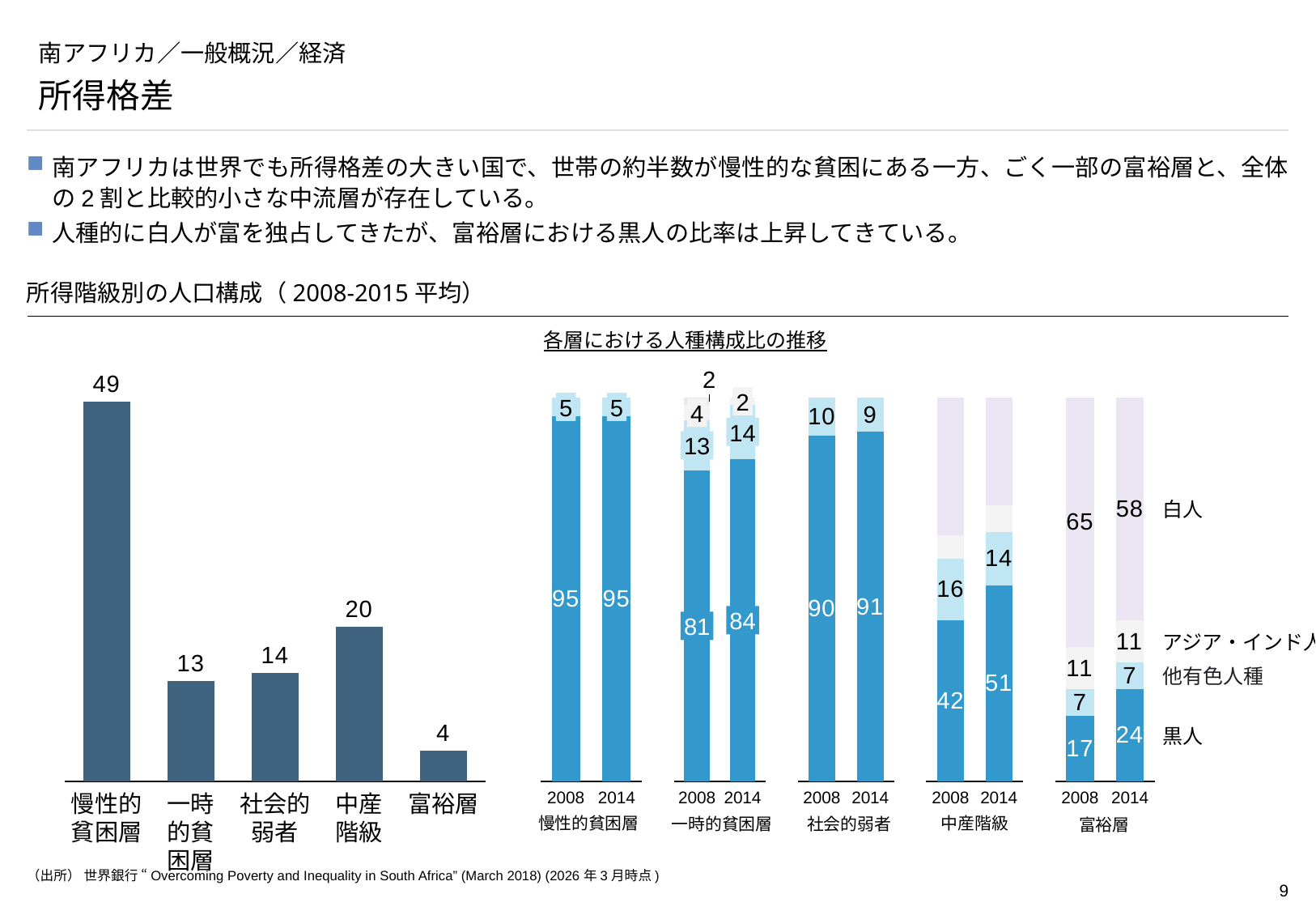
In the right chart (各層における人種構成比の推移), which is larger: the 黒人 value for 中産階級 in 2008 or in 2014? 2014 In the left chart (所得階級別の人口構成), what is the difference between 中産階級 and 富裕層? 16 In the right chart (各層における人種構成比の推移), what is the 白人 value for 富裕層 in 2008? 65 In the left chart (所得階級別の人口構成), what is the value for 慢性的貧困層? 49 What kind of chart is the left chart (所得階級別の人口構成)? Bar chart In the right chart (各層における人種構成比の推移), how many series does the legend list? 4 In the right chart (各層における人種構成比の推移), what is the difference between the 黒人 values for 一時的貧困層 in 2014 and 2008? 3 In the left chart (所得階級別の人口構成), how many categories are shown? 5 In the right chart (各層における人種構成比の推移), what is the 他有色人種 value for 社会的弱者 in 2014? 9 In the left chart (所得階級別の人口構成), which category has the highest value? 慢性的貧困層 In the left chart (所得階級別の人口構成), which category has the lowest value? 富裕層 In the right chart (各層における人種構成比の推移), what is the 黒人 value for 富裕層 in 2014? 24